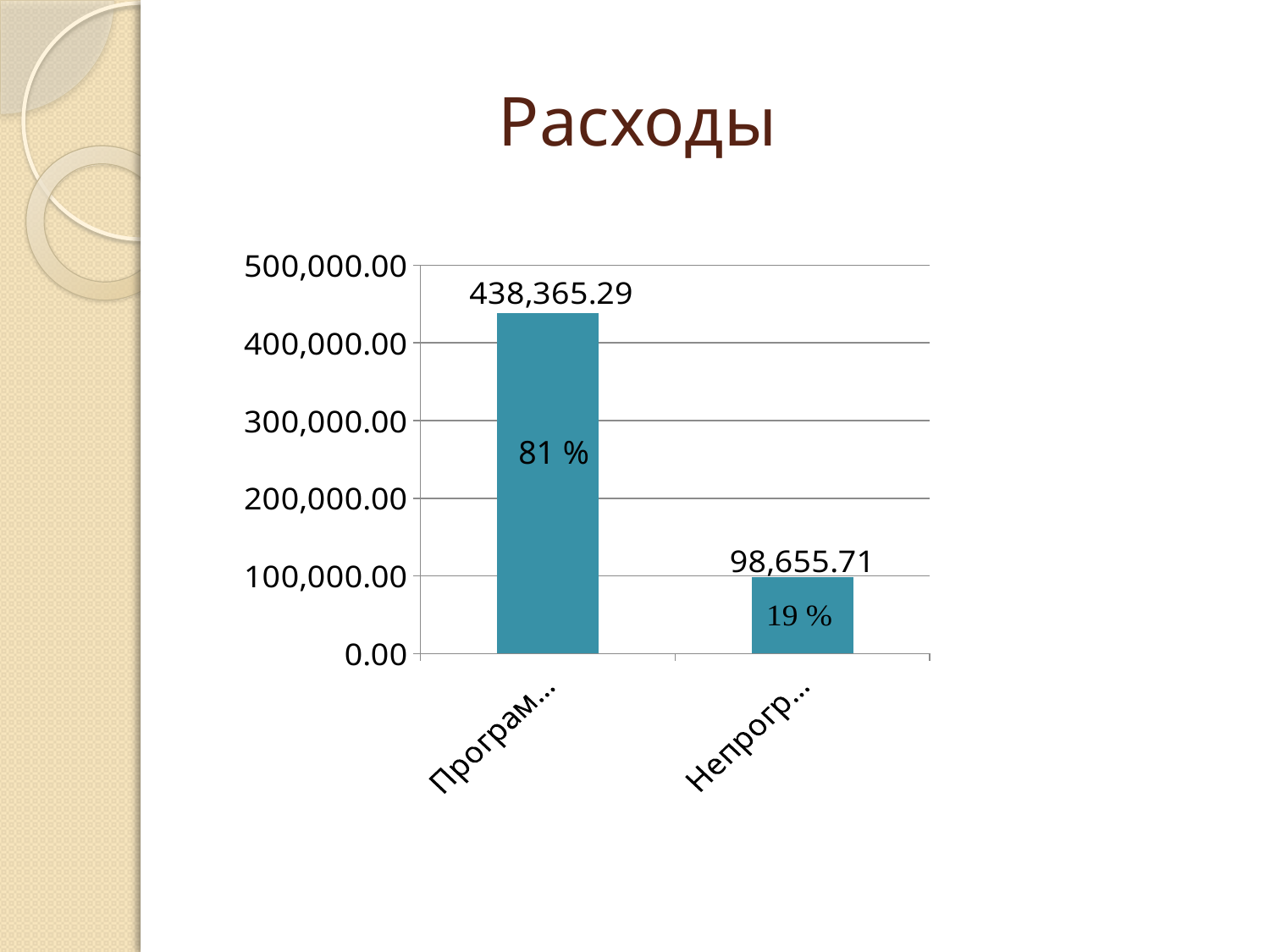
What percentage is printed inside the left bar ("Програм…") in the "Расходы" chart? 81 % How many bars are plotted in the "Расходы" chart? 2 What is the title of the chart on the slide? Расходы Which bar in the "Расходы" chart has the highest value? Програм… (the left bar) In the "Расходы" chart, is the value of the right bar ("Непрогр…") greater or less than 100,000.00? less Which bar in the "Расходы" chart has the lowest value? Непрогр… (the right bar) In the "Расходы" chart, is the value of the left bar ("Програм…") greater or less than 400,000.00? greater What type of chart is shown on the slide titled "Расходы"? bar chart What percentage is printed inside the right bar ("Непрогр…") in the "Расходы" chart? 19 % What is the difference between the left bar (438,365.29) and the right bar (98,655.71) in the "Расходы" chart? 339,709.58 What is the value of the left bar (labelled "Програм…") in the "Расходы" chart? 438,365.29 What is the value of the right bar (labelled "Непрогр…") in the "Расходы" chart? 98,655.71